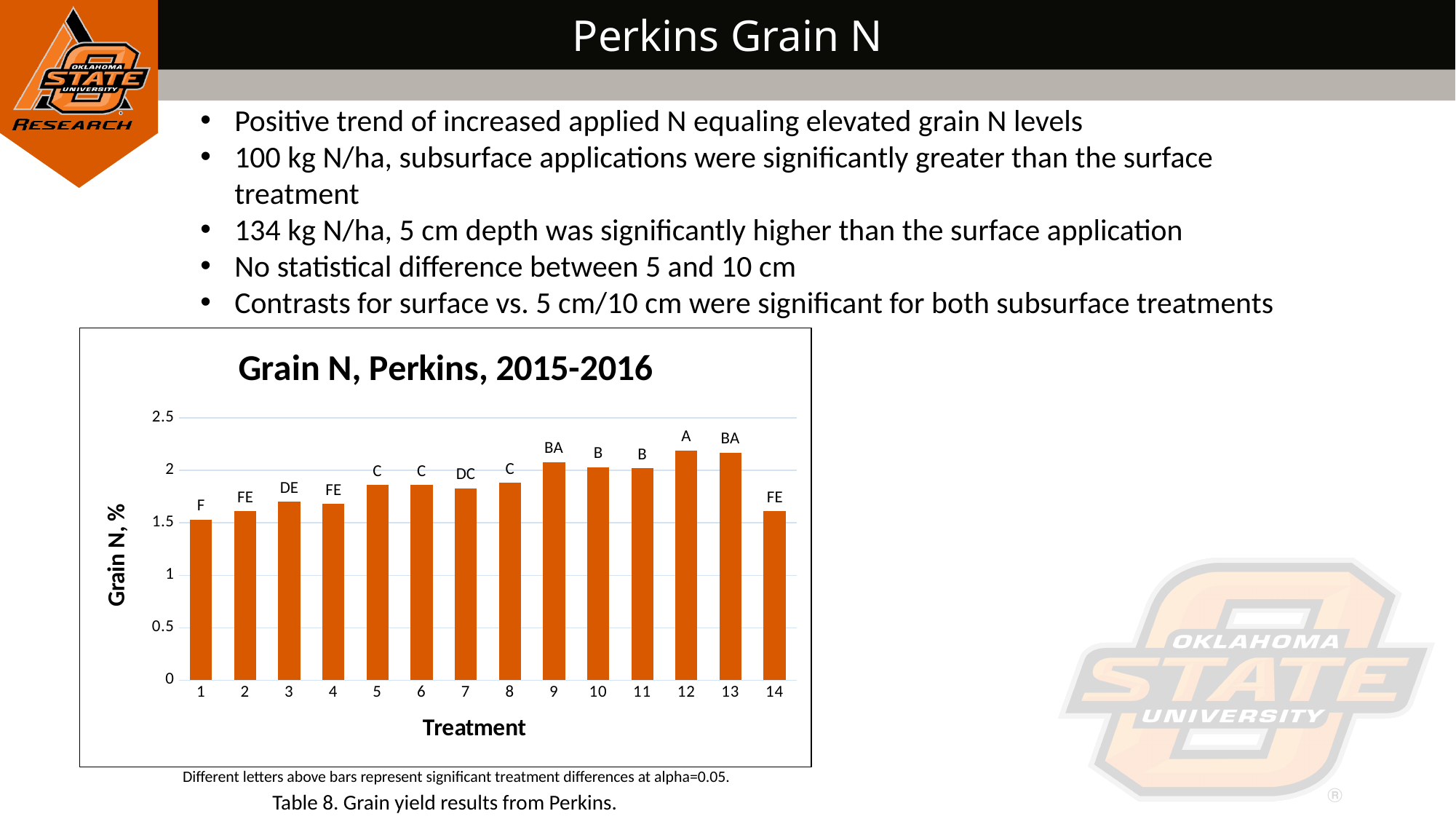
Do the Grain N, % values generally rise or fall from treatment 1 to treatment 12? rise Which treatment has the lowest Grain N, % in the chart? 1 What is the title of the chart? Grain N, Perkins, 2015-2016 How many treatments are plotted on the x axis of the Grain N, Perkins, 2015-2016 chart? 14 Is the Grain N, % value for treatment 5 greater or less than 2? less Which has a higher Grain N, %: treatment 12 or treatment 1? treatment 12 Is the Grain N, % value for treatment 7 greater or less than 2? less What type of chart is shown on the slide? bar chart Is the Grain N, % value for treatment 14 greater or less than 1.5? greater Which has a higher Grain N, %: treatment 3 or treatment 7? treatment 7 What letter label appears above the bar for treatment 12? A